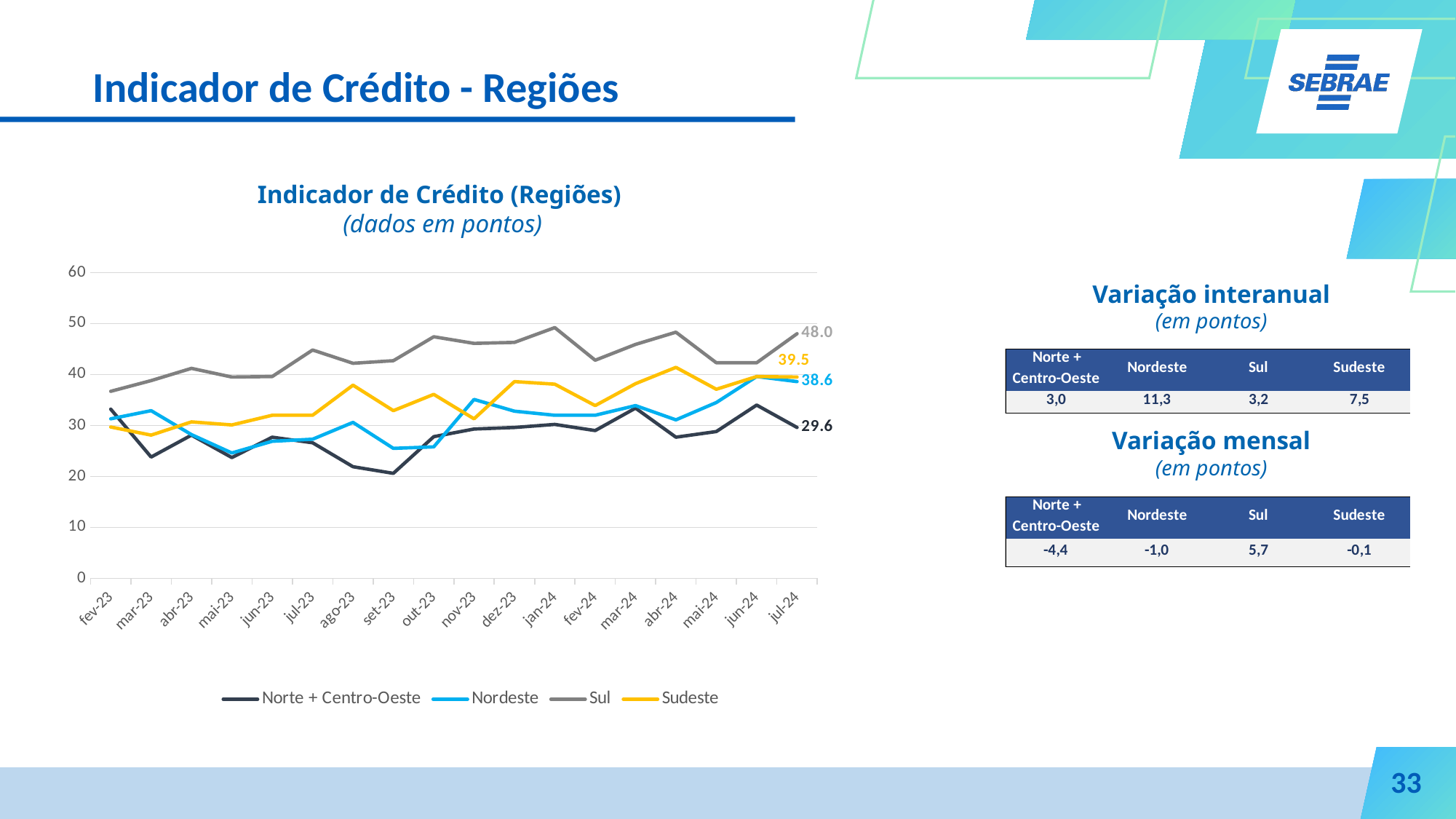
Which series has the highest value in jul-24? Sul How many months are shown on the x axis? 18 What is the value for Nordeste in jul-24? 38.6 Is the value for Norte + Centro-Oeste in set-23 greater or less than 30? less In jul-24, which is larger: Sudeste or Nordeste? Sudeste How many series does the legend list? 4 What is the difference between the Sul and Norte + Centro-Oeste values in jul-24? 18.4 What is the value for Sudeste in jul-24? 39.5 What is the value for Norte + Centro-Oeste in jul-24? 29.6 Which series has the lowest value in jul-24? Norte + Centro-Oeste What is the value for Sul in jul-24? 48.0 What kind of chart is shown on the slide? line chart